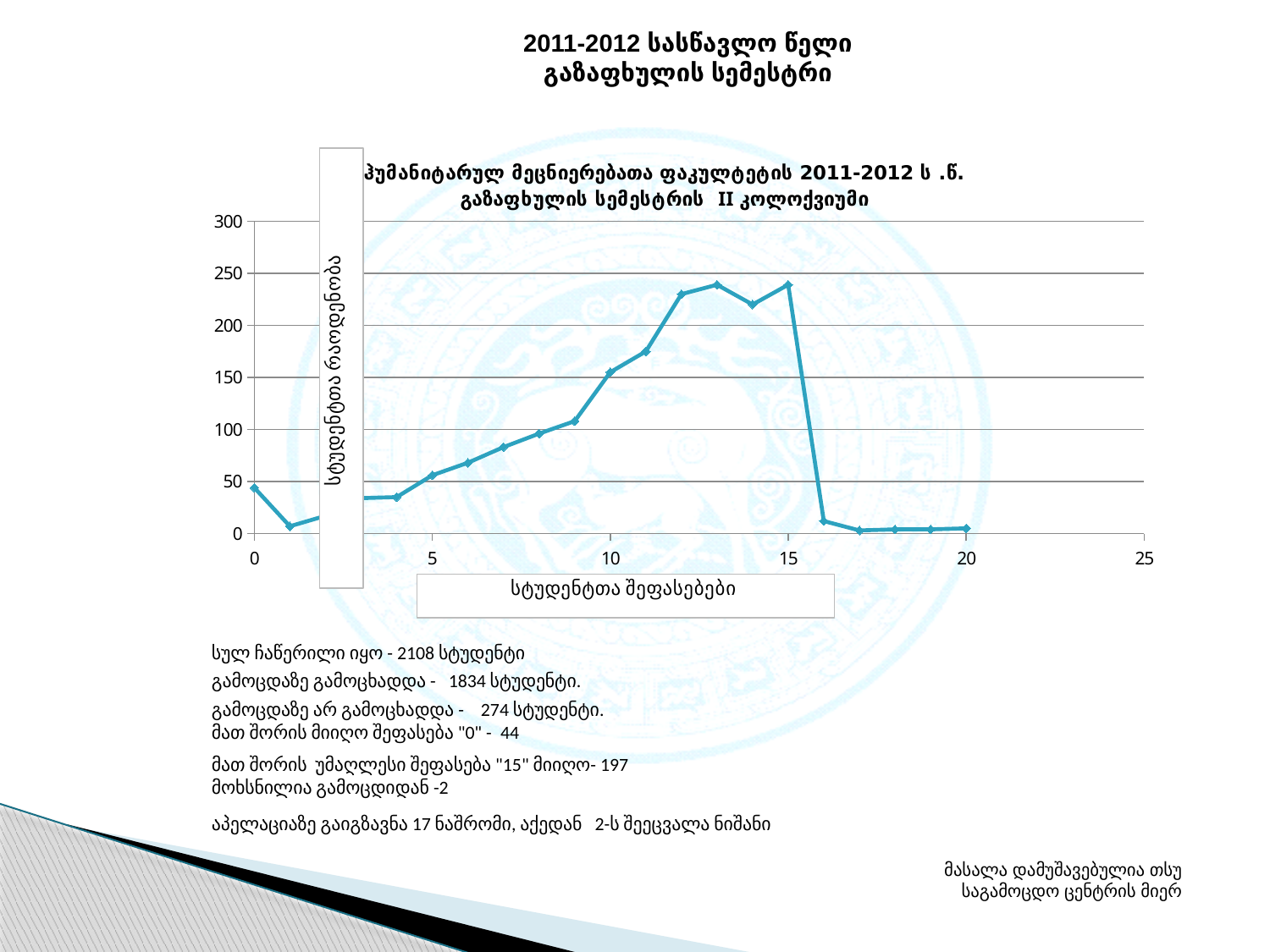
Do the values rise or fall as the score goes from 5 to 13? rise What kind of chart is shown on the slide? line chart What is the title of the vertical axis of the chart? სტუდენტთა რაოდენობა Which score has more students: 13 or 16? 13 Is the number of students with a score of 10 greater or less than 100? greater Is the number of students with a score of 0 greater or less than 100? less Is the number of students with a score of 12 greater or less than 200? greater Do the values rise or fall as the score goes from 15 to 17? fall What is the title of the horizontal axis of the chart? სტუდენტთა შეფასებები Which score has more students: 9 or 12? 12